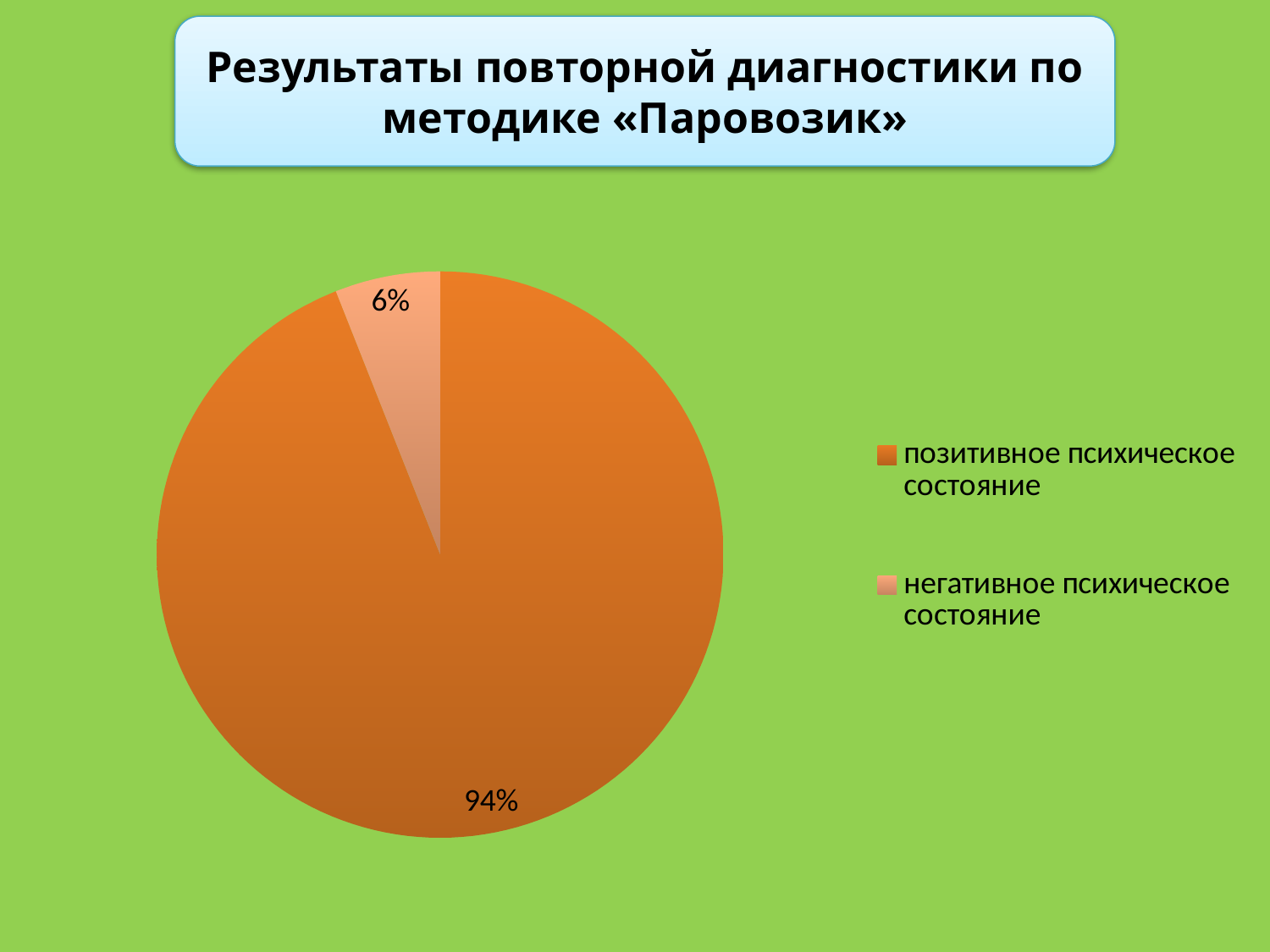
What is the total of the two percentages shown on the pie? 100% Which category has the largest slice of the pie? позитивное психическое состояние What is the difference in percentage points between the "позитивное психическое состояние" slice and the "негативное психическое состояние" slice? 88 How many entries does the legend list? 2 What share of the pie is labelled "негативное психическое состояние"? 6% What is the title shown above the chart? Результаты повторной диагностики по методике «Паровозик» How many slices does the pie chart have? 2 What kind of chart is shown on the slide? pie chart What share of the pie is labelled "позитивное психическое состояние"? 94% Which category has the smallest slice of the pie? негативное психическое состояние Is the share for "негативное психическое состояние" greater or less than 10%? less Which is larger: the slice for "позитивное психическое состояние" or the slice for "негативное психическое состояние"? позитивное психическое состояние